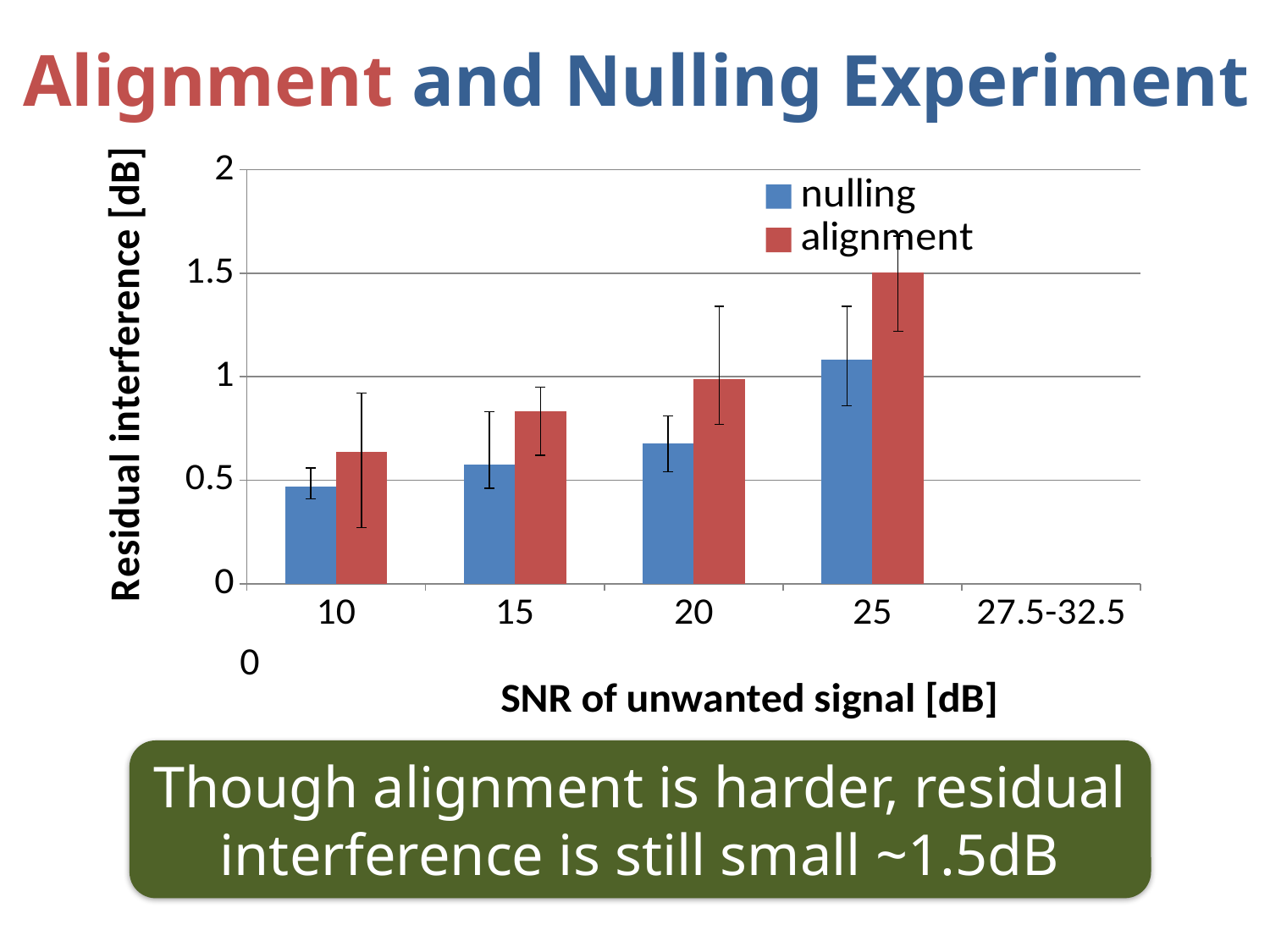
Which series are listed in the legend? nulling and alignment Is the nulling value at SNR 20 greater or less than 1? less Is the alignment value at SNR 10 greater or less than 0.5? greater How many SNR categories have bars plotted in the chart? 4 At which SNR value is the nulling bar lowest? 10 What kind of chart is shown on the slide? bar chart Do the nulling values rise or fall as the SNR of the unwanted signal increases? rise At which SNR value is the alignment bar highest? 25 What is the label of the y axis? Residual interference [dB] How many series does the legend list? 2 At SNR 25, which series has the larger residual interference, nulling or alignment? alignment Is the nulling value at SNR 25 greater or less than 1? greater